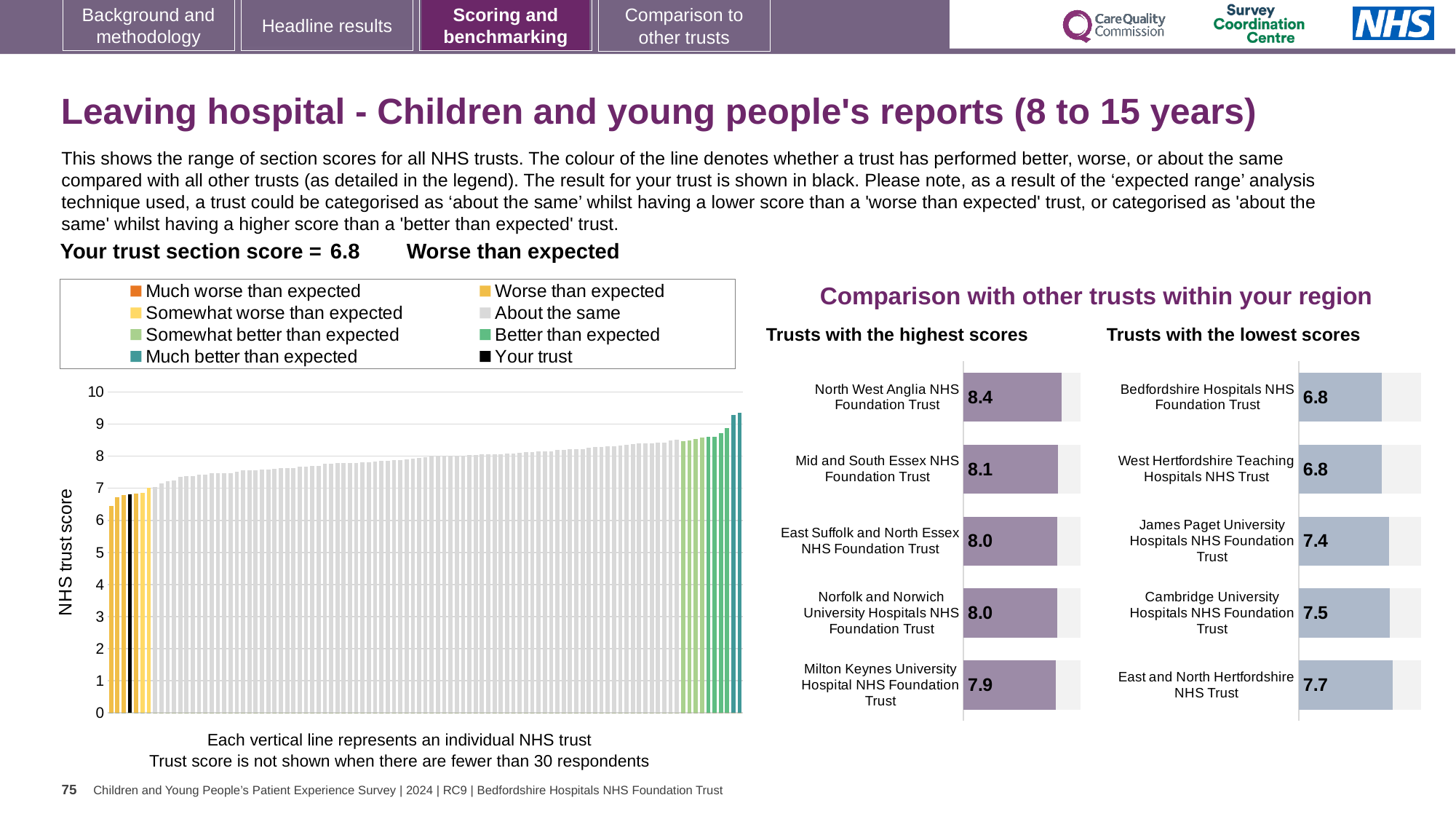
In the 'Trusts with the highest scores' chart, what is the score for North West Anglia NHS Foundation Trust? 8.4 In the 'Trusts with the highest scores' chart, what is the difference between the scores of North West Anglia NHS Foundation Trust and Milton Keynes University Hospital NHS Foundation Trust? 0.5 In the 'Trusts with the lowest scores' chart, what is the score for James Paget University Hospitals NHS Foundation Trust? 7.4 How many trusts are listed in the 'Trusts with the highest scores' chart? 5 In the main chart on the left showing all NHS trusts, is the value for the black bar (your trust) greater or less than 7? less In the main chart on the left showing all NHS trusts, do the bar values rise or fall from left to right? rise How many entries does the legend above the main chart on the left list? 8 In the 'Trusts with the lowest scores' chart, what is the difference between the scores of East and North Hertfordshire NHS Trust and Bedfordshire Hospitals NHS Foundation Trust? 0.9 In the 'Trusts with the lowest scores' chart, which has the higher score: Cambridge University Hospitals NHS Foundation Trust or James Paget University Hospitals NHS Foundation Trust? Cambridge University Hospitals NHS Foundation Trust In the 'Trusts with the highest scores' chart, which trust has the lowest score shown? Milton Keynes University Hospital NHS Foundation Trust In the 'Trusts with the lowest scores' chart, which trust has the highest score shown? East and North Hertfordshire NHS Trust What kind of chart is the main chart on the left showing all NHS trusts? bar chart